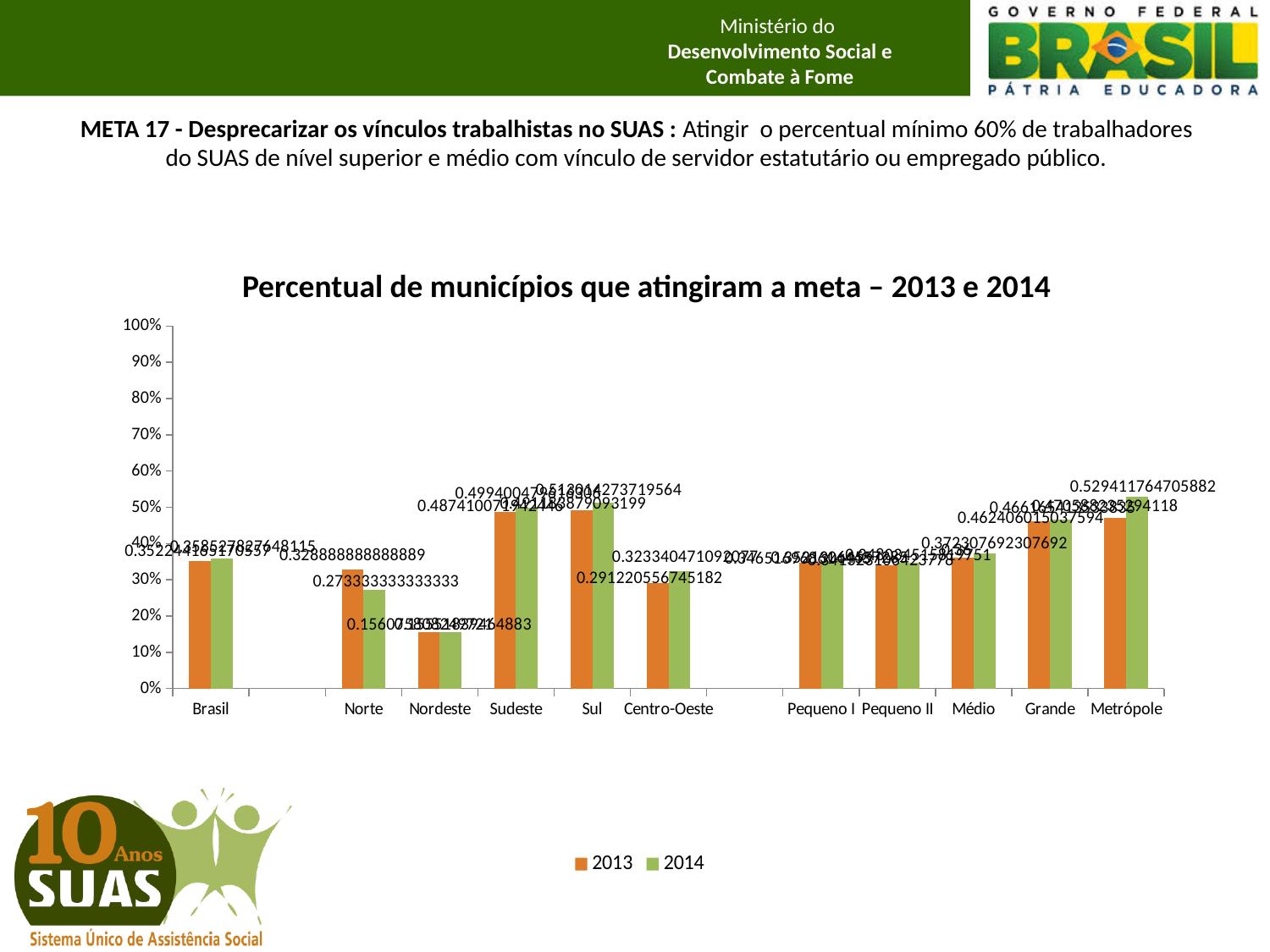
What is the value for Grande in 2013? 0.462406015037594 What is the value for Centro-Oeste in 2013? 0.291220556745182 Which category has the highest value for 2014? Metrópole What is the value for Metrópole in 2014? 0.529411764705882 How many series does the legend list? 2 Is the value for Nordeste in 2014 greater or less than 20%? less What is the value for Norte in 2013? 0.328888888888889 Which is larger for Norte: the 2013 value or the 2014 value? 2013 What kind of chart is shown on the slide? Bar chart Which category has the lowest values in both years? Nordeste How many categories are shown on the x axis of the chart? 11 What is the value for Norte in 2014? 0.273333333333333